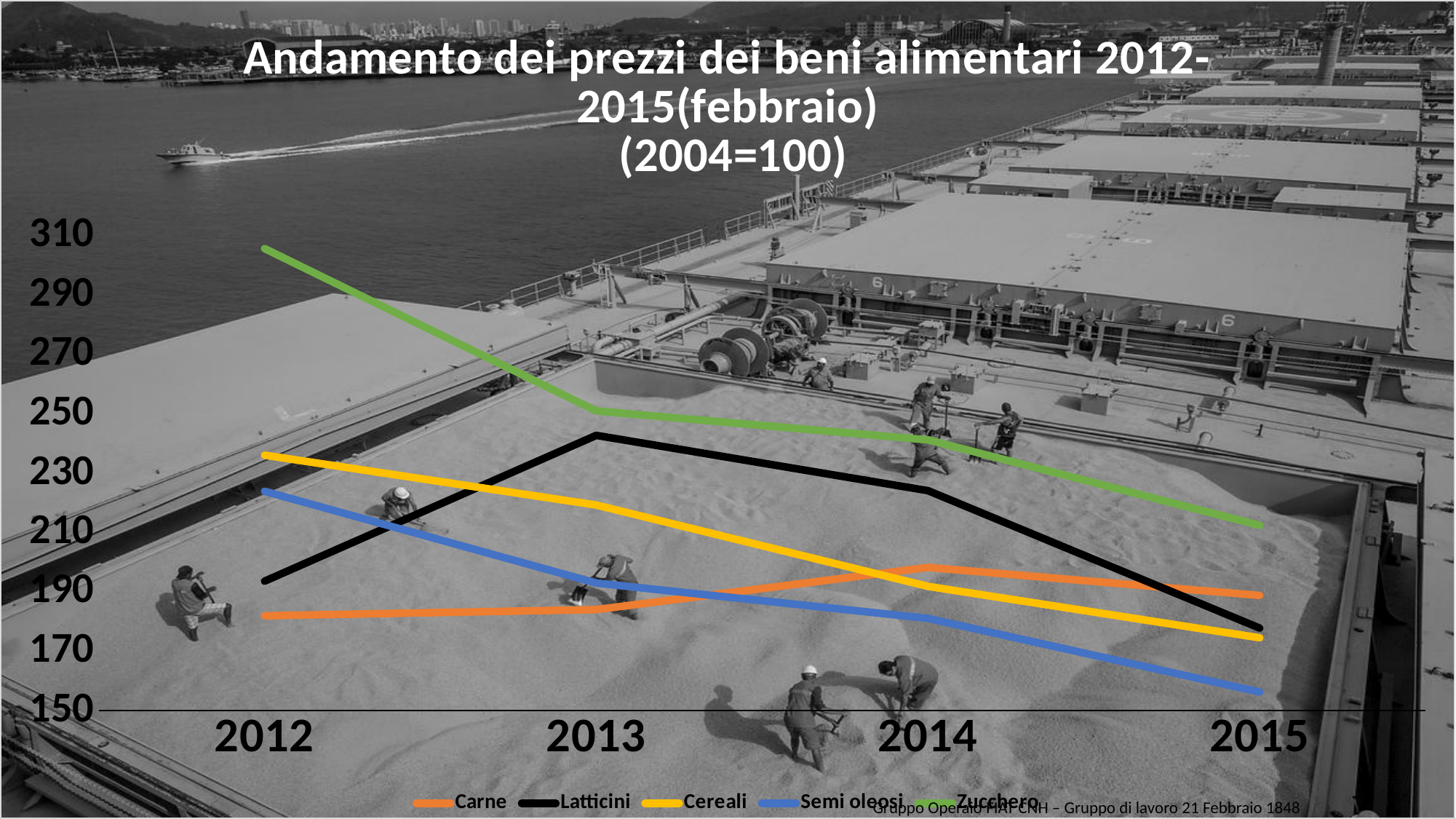
Is the value for Semi oleosi in 2015 greater or less than 170? less Is the value for Zucchero in 2012 greater or less than 290? greater Is the value for Latticini in 2013 greater or less than 230? greater What kind of chart is shown on the slide? line chart What colour is the Zucchero line? green Which series has the lowest value in 2015? Semi oleosi In 2013, which is higher: Latticini or Cereali? Latticini Which series has the highest value in 2012? Zucchero Which series has the lowest value in 2012? Carne How many years are shown on the x axis? 4 How many series does the legend list? 5 Does the Zucchero line rise or fall from 2012 to 2015? fall